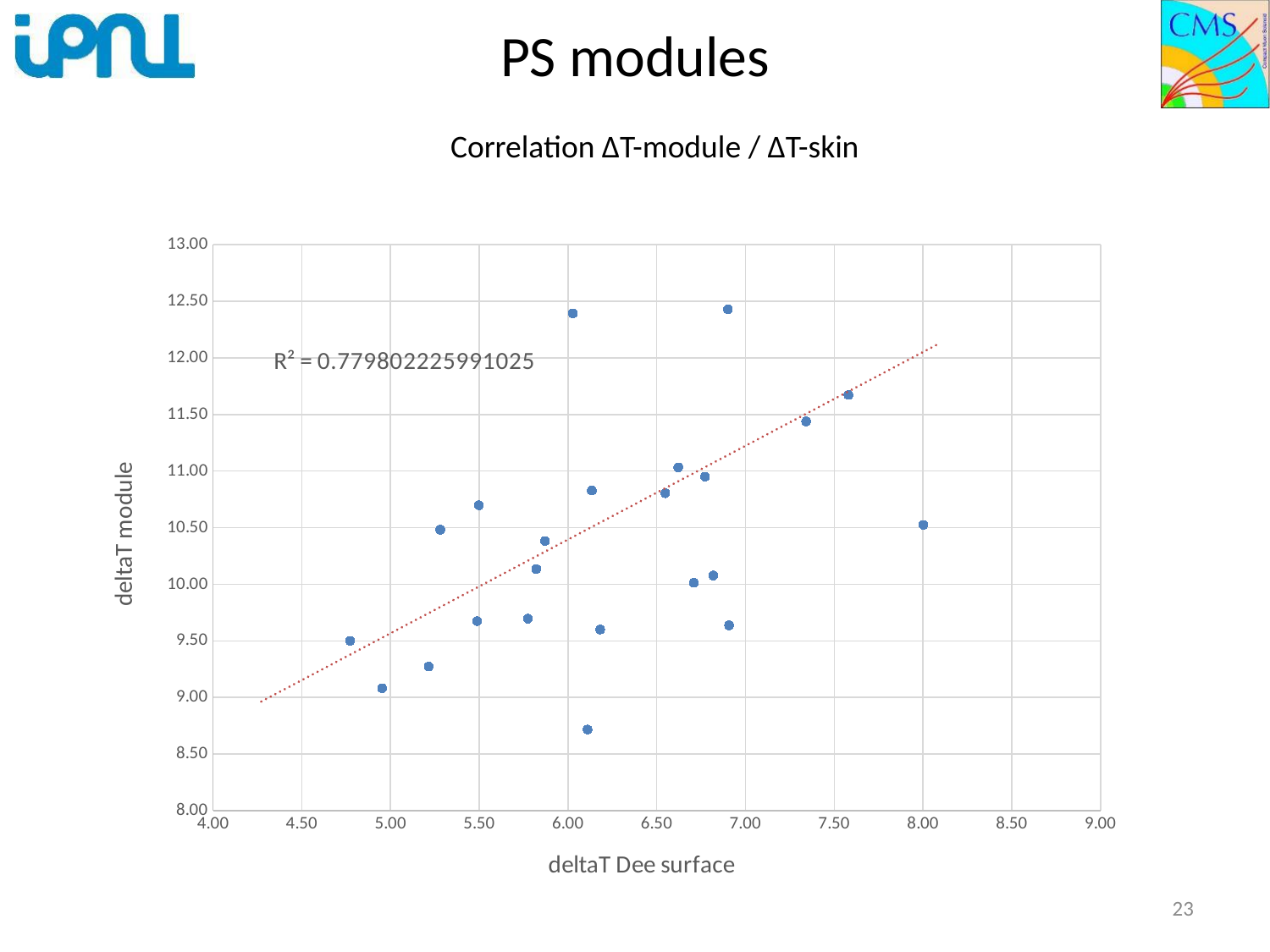
What is the label of the x axis? deltaT Dee surface Is the deltaT module value of the lowest point on the chart greater or less than 9.00? less Is the deltaT module value of the leftmost point (near deltaT Dee surface 4.75) greater or less than 10.00? less Is the deltaT module value of the highest point on the chart greater or less than 12.00? greater What is the maximum value shown on the y axis? 13.00 Which has the larger deltaT module value: the point near deltaT Dee surface 7.50 or the point near deltaT Dee surface 8.00? the point near 7.50 What kind of chart is shown on the slide? scatter chart Do the deltaT module values generally rise or fall as deltaT Dee surface increases, according to the trendline? rise What is the R² value printed on the chart? R² = 0.779802225991025 What is the title of the chart? Correlation ΔT-module / ΔT-skin